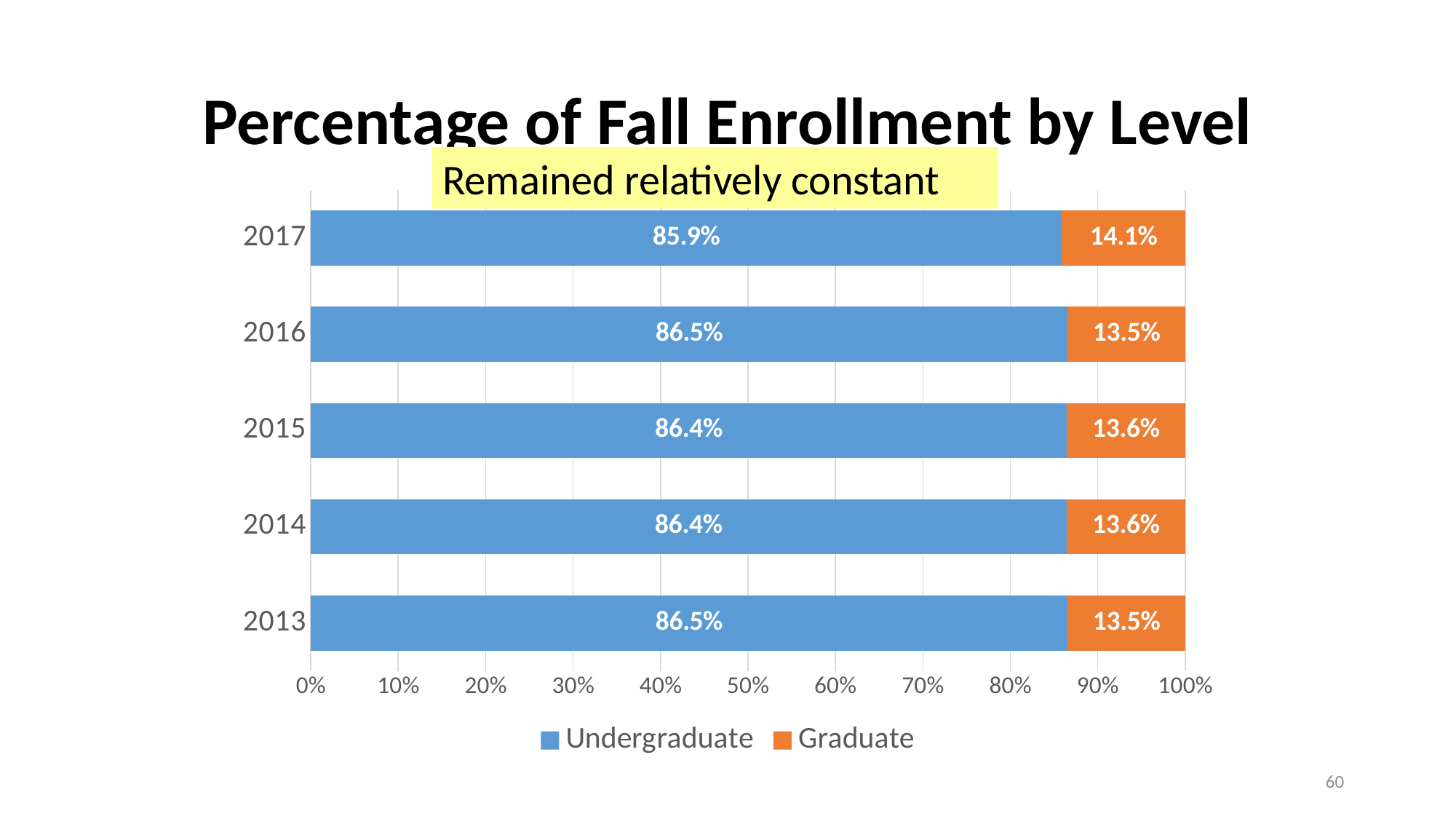
How many years are shown on the chart? 5 What is the Graduate percentage for 2013? 13.5% What is the difference between the Undergraduate and Graduate percentages in 2016? 73.0% What kind of chart is shown on the slide? Stacked bar chart How many series does the legend list? 2 Which year has the highest Graduate percentage? 2017 Is the Undergraduate value for 2013 greater or less than 80%? greater What is the title of the chart? Percentage of Fall Enrollment by Level Which year has the lowest Undergraduate percentage? 2017 What is the Undergraduate percentage for 2017? 85.9% What is the Graduate percentage for 2015? 13.6% Is the Undergraduate percentage for 2014 larger than the Graduate percentage for 2014? Yes